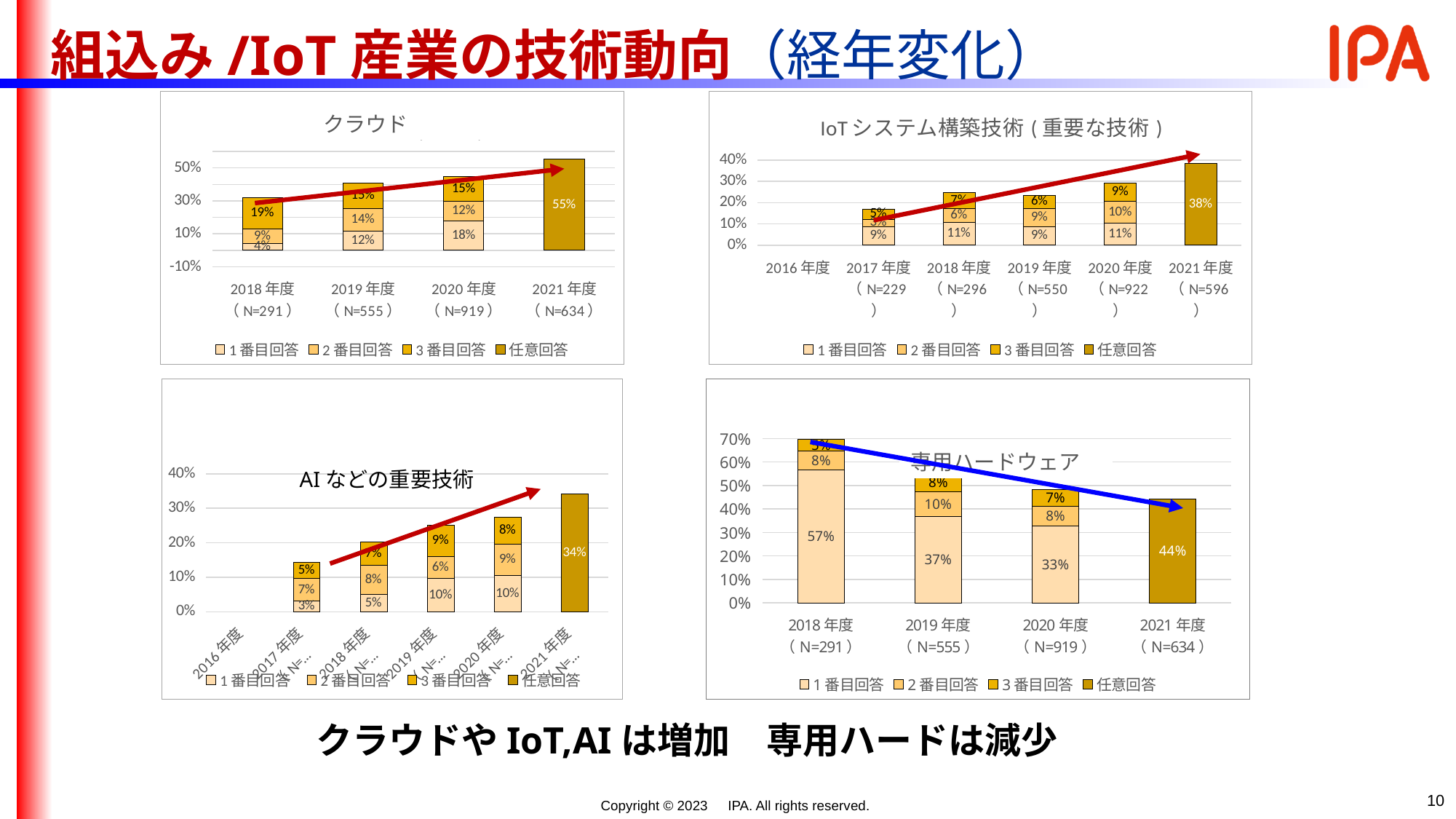
In the 専用ハードウェア chart, what is the total of the stacked bar for 2019年度? 55% In the 専用ハードウェア chart, what is the difference between the 1番目回答 values for 2018年度 and 2020年度? 24 percentage points In the 専用ハードウェア chart, what is the 1番目回答 value for 2018年度? 57% In the 専用ハードウェア chart, which year has the higher 1番目回答 value, 2019年度 or 2020年度? 2019年度 What kind of chart is the 専用ハードウェア chart? Stacked bar chart How many series does the legend of the クラウド chart list? 4 In the 専用ハードウェア chart, do the total bar heights rise or fall from 2018年度 to 2021年度? Fall In the クラウド chart, what is the value of the 任意回答 bar for 2021年度? 55% In the IoTシステム構築技術 chart, what is the value of the 任意回答 bar for 2021年度? 38% In the AIなどの重要技術 chart, what is the value of the 任意回答 bar for 2021年度? 34% How many year categories are shown on the x axis of the 専用ハードウェア chart? 4 In the 専用ハードウェア chart, what is the value of the 任意回答 bar for 2021年度? 44%